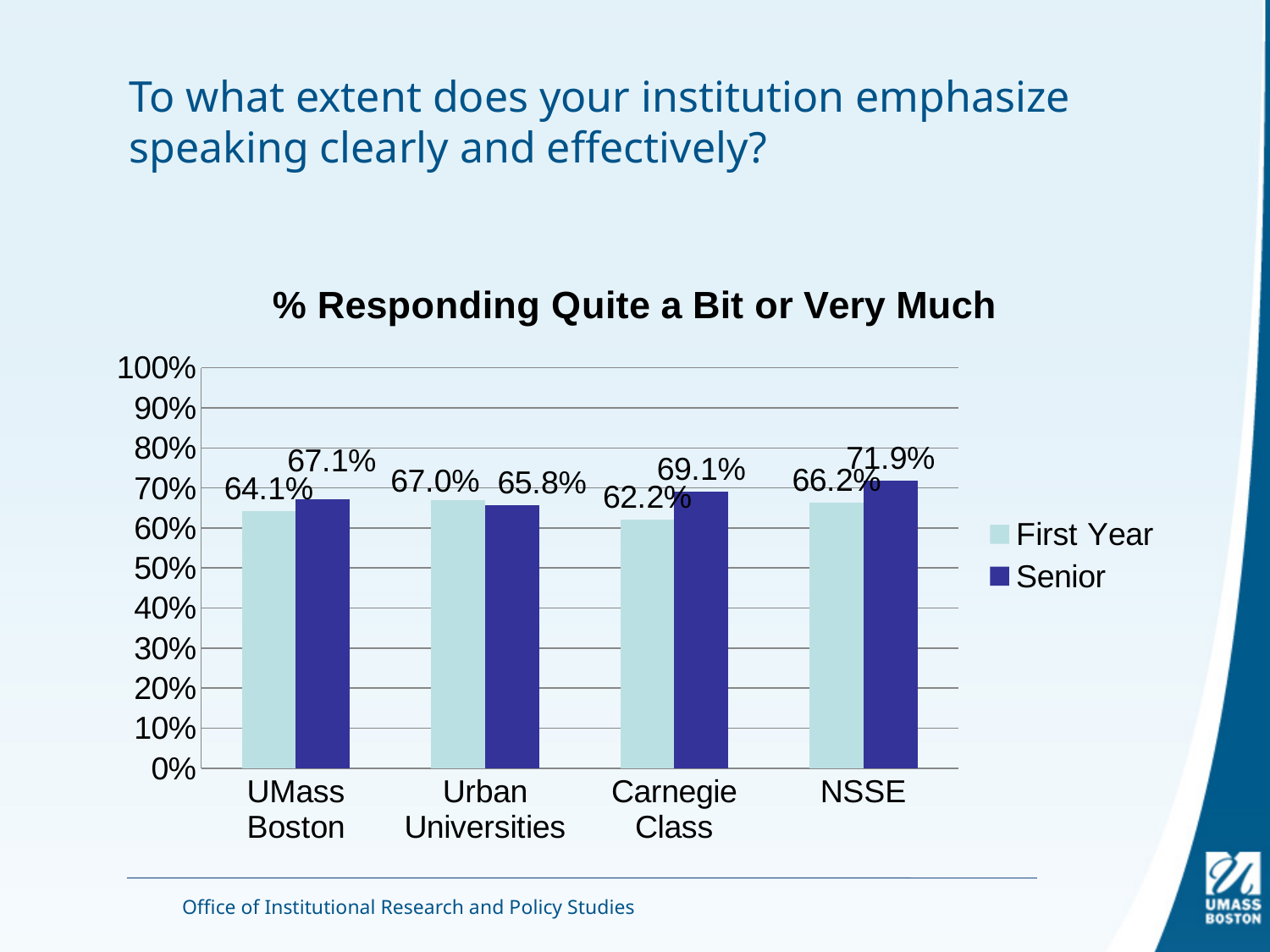
How many series does the legend list? 2 Which category has the lowest First Year value? Carnegie Class What is the First Year value for Carnegie Class? 62.2% Which is larger for Urban Universities, the First Year value or the Senior value? First Year What is the First Year value for UMass Boston? 64.1% What kind of chart is shown on the slide? Bar chart What is the Senior value for NSSE? 71.9% What is the Senior value for Urban Universities? 65.8% What is the difference between the Senior and First Year values for Carnegie Class? 6.9% What is the title of the chart? % Responding Quite a Bit or Very Much How many categories are shown on the x axis? 4 Which category has the highest Senior value? NSSE